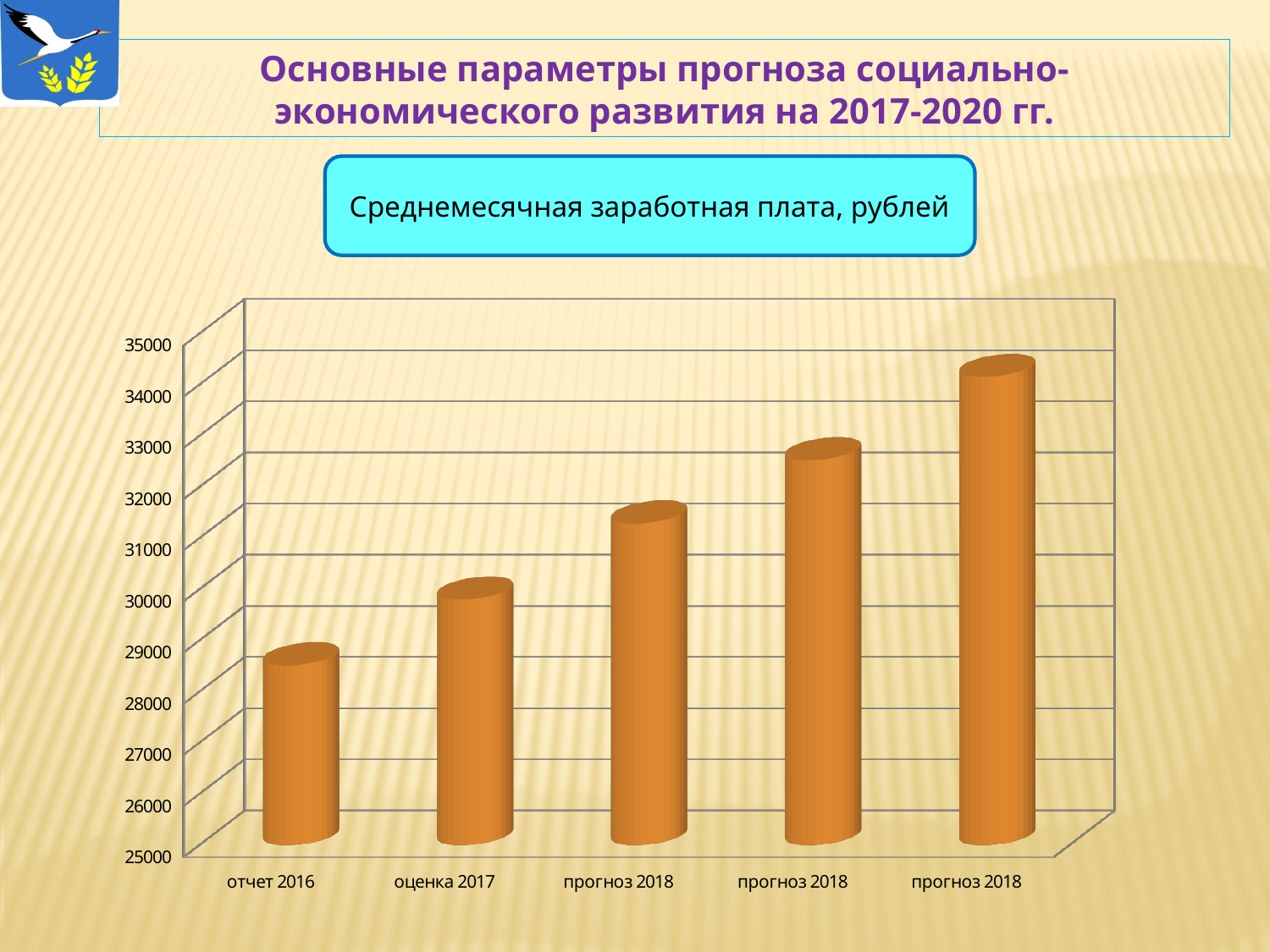
Which bar has the highest value? the rightmost bar (прогноз 2018) What is the title shown above the chart? Среднемесячная заработная плата, рублей Is the value for оценка 2017 greater or less than 29000? greater Is the value for отчет 2016 greater or less than 28000? greater What kind of chart is shown on the slide? bar chart Which category has the lowest value? отчет 2016 Is the value for отчет 2016 greater or less than 30000? less Which is larger, the value for отчет 2016 or the value for оценка 2017? оценка 2017 How many bars are plotted in the chart? 5 Do the values rise or fall from left to right along the x axis? rise